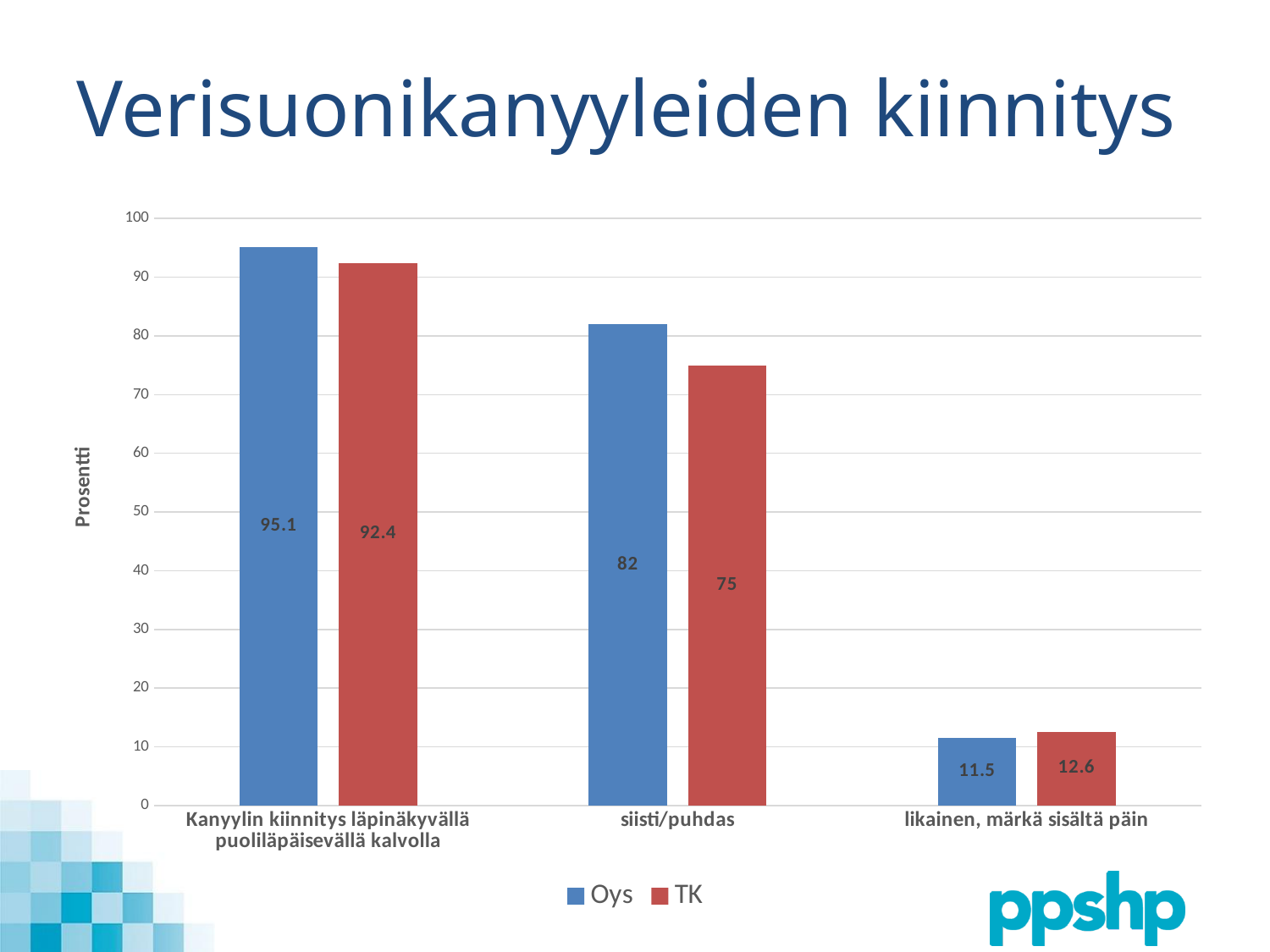
Which category has the highest Oys value? Kanyylin kiinnitys läpinäkyvällä puoliläpäisevällä kalvolla What is the TK value for "likainen, märkä sisältä päin"? 12.6 Which category has the lowest TK value? likainen, märkä sisältä päin How many categories are shown on the x axis? 3 Is the Oys value for "siisti/puhdas" greater or less than 70? greater What is the Oys value for "siisti/puhdas"? 82 What is the difference between the Oys and TK values for "Kanyylin kiinnitys läpinäkyvällä puoliläpäisevällä kalvolla"? 2.7 What is the TK value for "Kanyylin kiinnitys läpinäkyvällä puoliläpäisevällä kalvolla"? 92.4 What is the difference between the Oys and TK values for "siisti/puhdas"? 7 How many series does the legend list? 2 What type of chart is shown on the slide? bar chart For "likainen, märkä sisältä päin", which series has the larger value, Oys or TK? TK